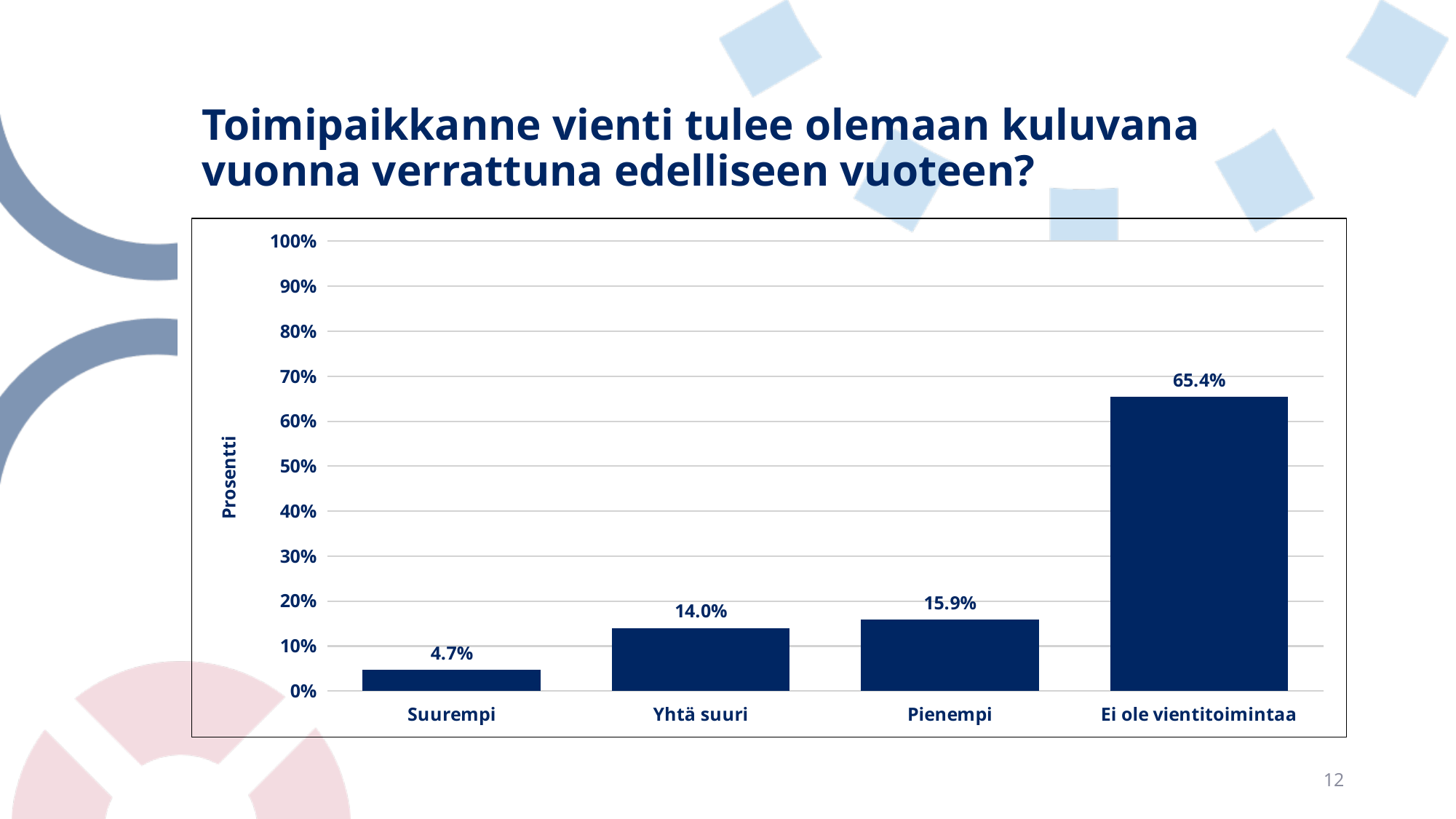
What is the value for Pienempi? 15.9% What is the difference between the values for Ei ole vientitoimintaa and Pienempi? 49.5% Which category has the highest value? Ei ole vientitoimintaa Which is larger, the value for Pienempi or the value for Yhtä suuri? Pienempi What is the difference between the values for Pienempi and Yhtä suuri? 1.9% What kind of chart is shown on the slide? Bar chart What is the label of the y axis? Prosentti Which category has the lowest value? Suurempi What is the value for Ei ole vientitoimintaa? 65.4% What is the value for Suurempi? 4.7% What is the value for Yhtä suuri? 14.0% How many categories are shown on the x axis? 4